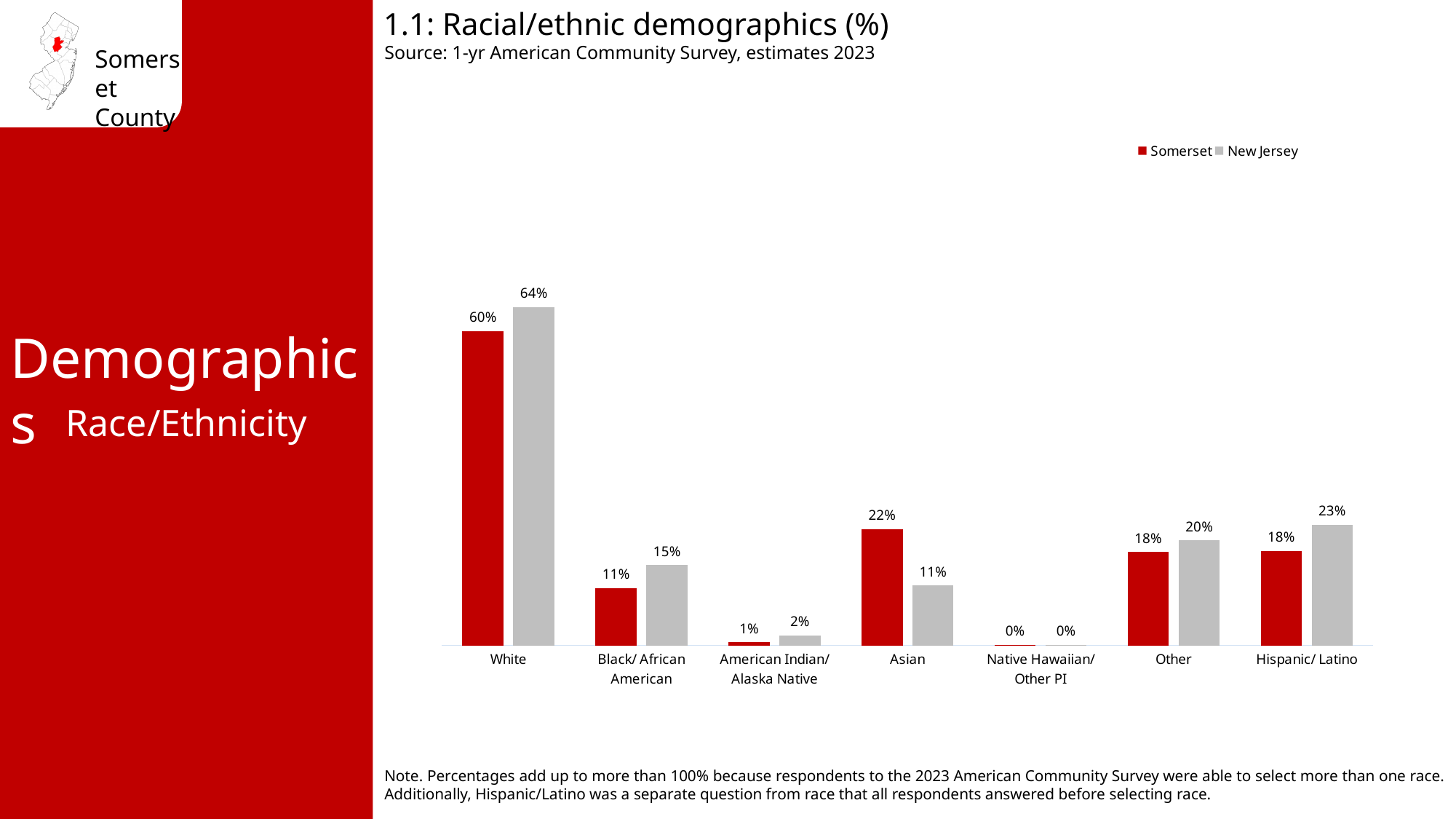
How many categories are shown on the x axis? 7 How many series does the legend list? 2 Which category has the highest Somerset value? White What is the difference between the New Jersey and Somerset values for White? 4% What is the difference between the Somerset and New Jersey values for Asian? 11% What is the Somerset value for White? 60% Which is larger for Other: the Somerset value or the New Jersey value? New Jersey What is the Somerset value for Black/ African American? 11% What is the New Jersey value for Asian? 11% What is the New Jersey value for Hispanic/ Latino? 23% Which category has the lowest New Jersey value? Native Hawaiian/ Other PI What kind of chart is shown on the slide? Bar chart